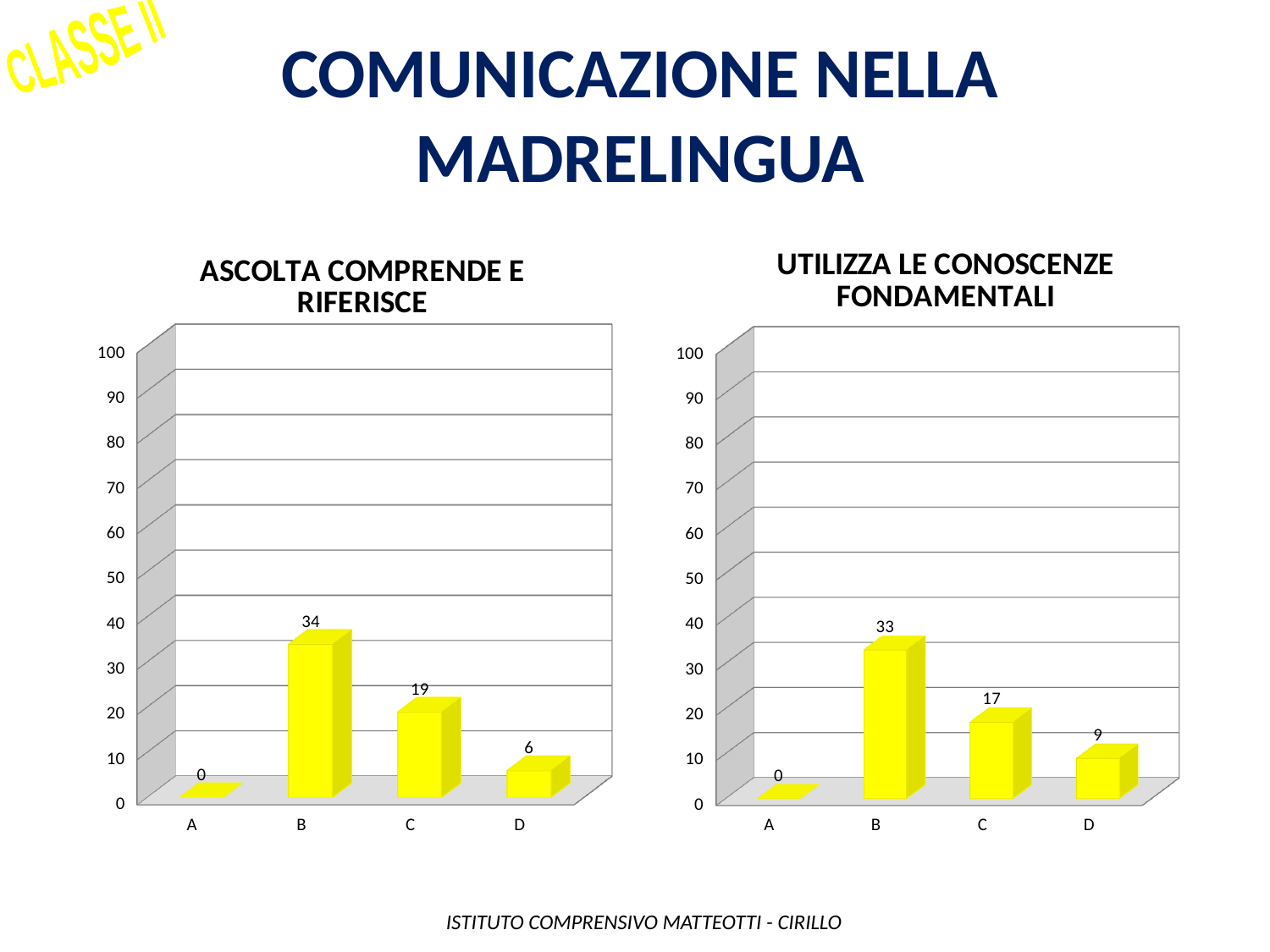
In the chart titled 'ASCOLTA COMPRENDE E RIFERISCE', is the value for B greater or less than 30? greater In the chart titled 'UTILIZZA LE CONOSCENZE FONDAMENTALI', what is the value for category C? 17 What kind of chart is the chart titled 'ASCOLTA COMPRENDE E RIFERISCE'? Bar chart In the chart titled 'UTILIZZA LE CONOSCENZE FONDAMENTALI', what is the difference between the values for B and D? 24 In the chart titled 'ASCOLTA COMPRENDE E RIFERISCE', what is the value for category D? 6 In the chart titled 'UTILIZZA LE CONOSCENZE FONDAMENTALI', which category has the lowest value? A In the chart titled 'UTILIZZA LE CONOSCENZE FONDAMENTALI', which is larger, the value for C or the value for D? C What colour are the bars in the chart titled 'UTILIZZA LE CONOSCENZE FONDAMENTALI'? Yellow In the chart titled 'ASCOLTA COMPRENDE E RIFERISCE', what is the difference between the values for B and C? 15 In the chart titled 'ASCOLTA COMPRENDE E RIFERISCE', what is the value for category B? 34 How many categories are shown in the chart titled 'UTILIZZA LE CONOSCENZE FONDAMENTALI'? 4 In the chart titled 'ASCOLTA COMPRENDE E RIFERISCE', which category has the highest value? B